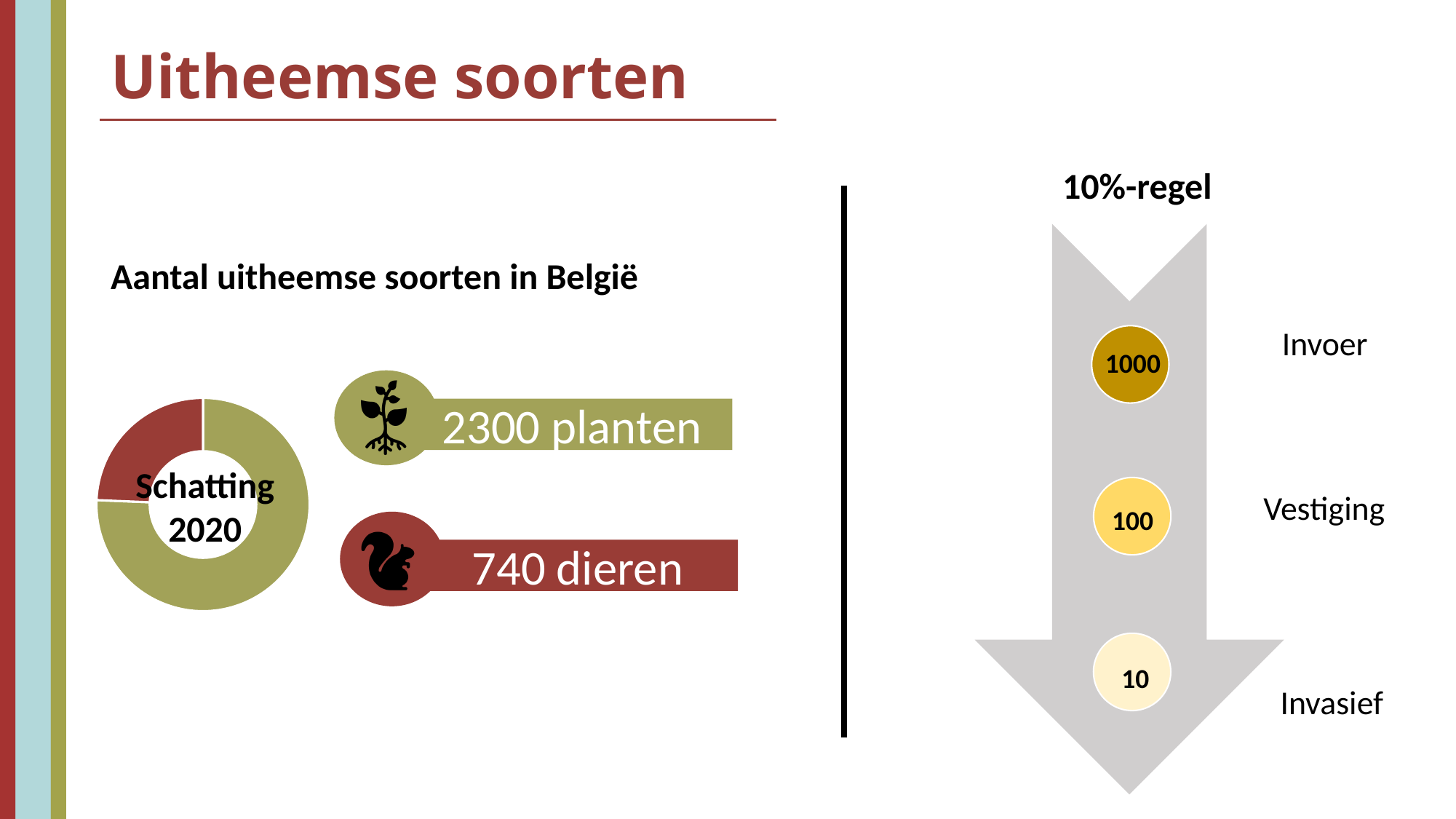
How many categories does the 'Aantal uitheemse soorten in België' chart show? 2 In the 'Aantal uitheemse soorten in België' chart, what is the difference between the number of planten and the number of dieren? 1560 What kind of chart is the 'Aantal uitheemse soorten in België' chart? donut (pie) chart In the 'Aantal uitheemse soorten in België' chart, what is the total of planten and dieren? 3040 In the 'Aantal uitheemse soorten in België' chart, what colour is the dieren segment? red In the 'Aantal uitheemse soorten in België' chart, which category has the largest segment? planten What text is shown in the centre of the 'Aantal uitheemse soorten in België' donut chart? Schatting 2020 In the 'Aantal uitheemse soorten in België' chart, what is the value for dieren? 740 In the '10%-regel' diagram on the right, what value is shown for Vestiging? 100 In the 'Aantal uitheemse soorten in België' chart, which category has the smallest segment? dieren In the 'Aantal uitheemse soorten in België' chart, which is larger: planten or dieren? planten In the 'Aantal uitheemse soorten in België' chart, what is the value for planten? 2300